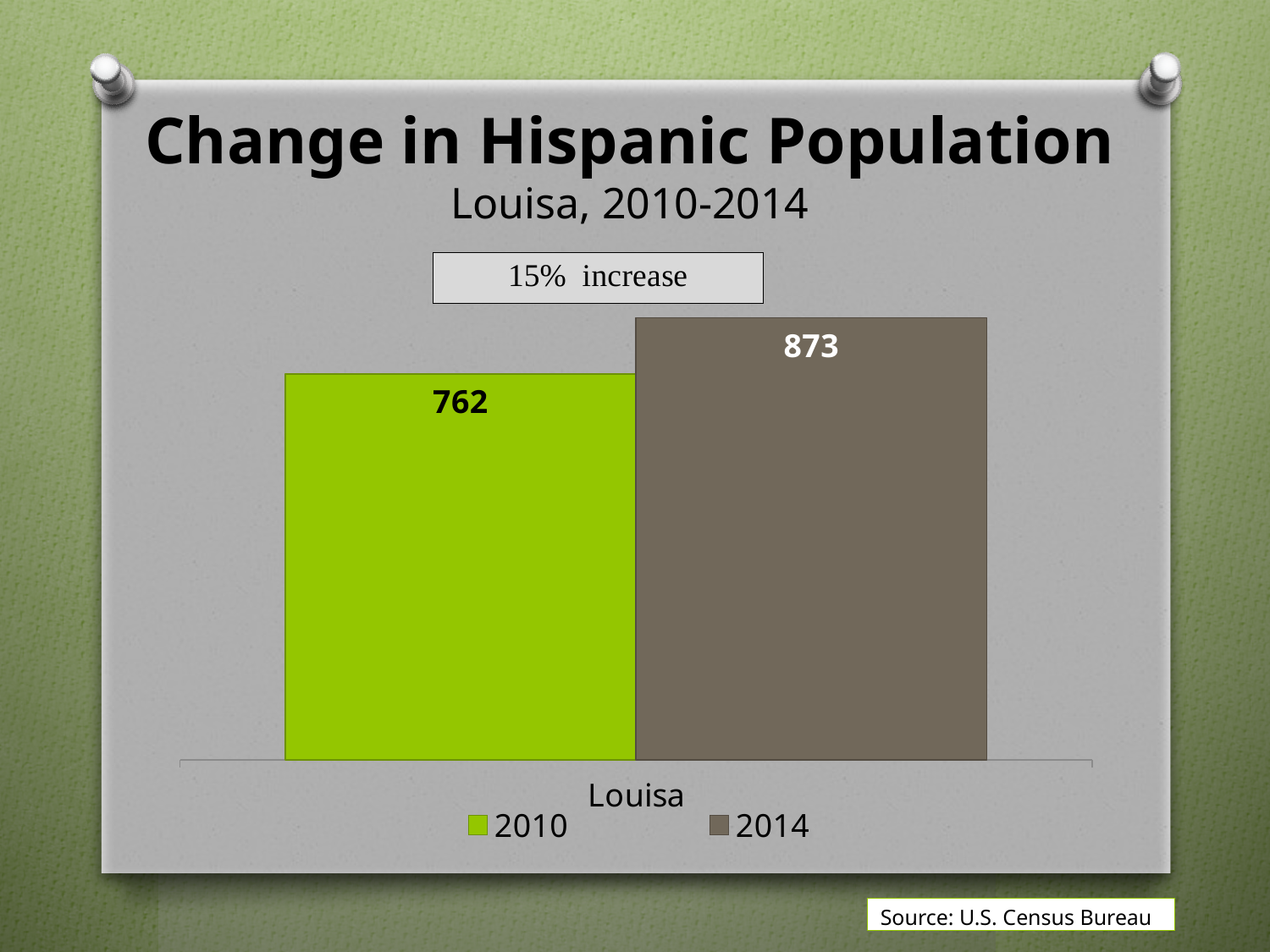
By how much did the Hispanic population of Louisa increase from 2010 to 2014? 111 Which series has the lowest value on the chart? 2010 What kind of chart is shown on the slide? Bar chart What was the Hispanic population of Louisa in 2014 according to the chart? 873 How many series does the legend list? 2 What was the Hispanic population of Louisa in 2010 according to the chart? 762 Which year shows the higher Hispanic population for Louisa, 2010 or 2014? 2014 Which colour represents the 2010 series in the legend? Green What percentage increase does the label above the bars state? 15% increase How many categories are shown on the x axis? 1 Did the Hispanic population of Louisa rise or fall between 2010 and 2014? Rise